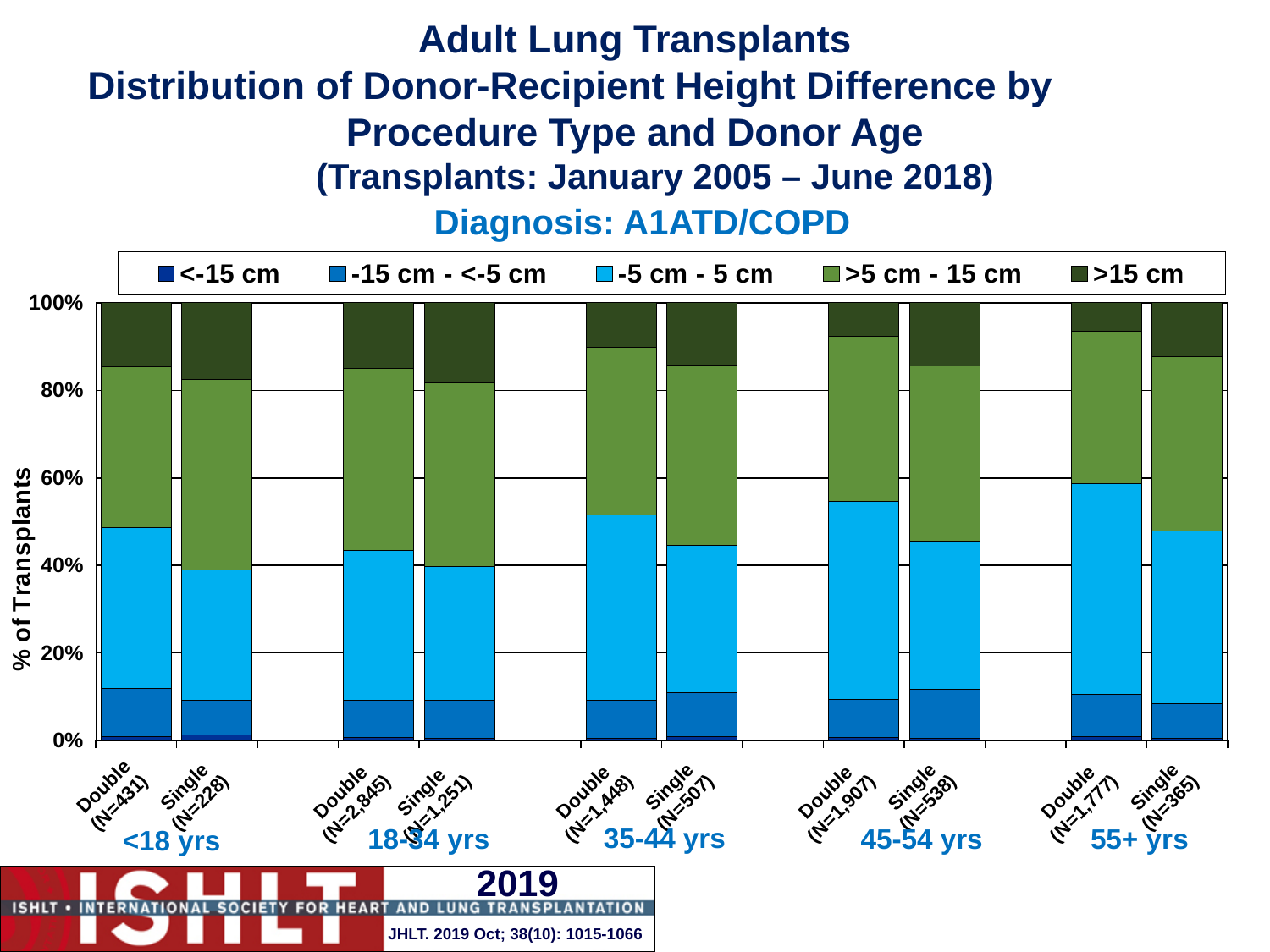
How many bars are plotted in the chart? 10 What is the N shown for Double lung transplants in the 18-34 yrs donor age group? N=2,845 How many donor age groups are shown along the x axis? 5 In the 55+ yrs group, is the -5 cm - 5 cm segment larger for the Double bar or the Single bar? Double In the <18 yrs group, is the >5 cm - 15 cm segment larger for the Double bar or the Single bar? Single What is the N shown for Single lung transplants in the 55+ yrs donor age group? N=365 Which diagnosis group does the chart cover, according to the subtitle? A1ATD/COPD How many series does the legend list? 5 For the Double (N=1,777) bar in the 55+ yrs group, does the top of the -5 cm - 5 cm segment sit above or below the 40% gridline? above What is the label of the y axis? % of Transplants What kind of chart is shown on the slide? Stacked bar chart